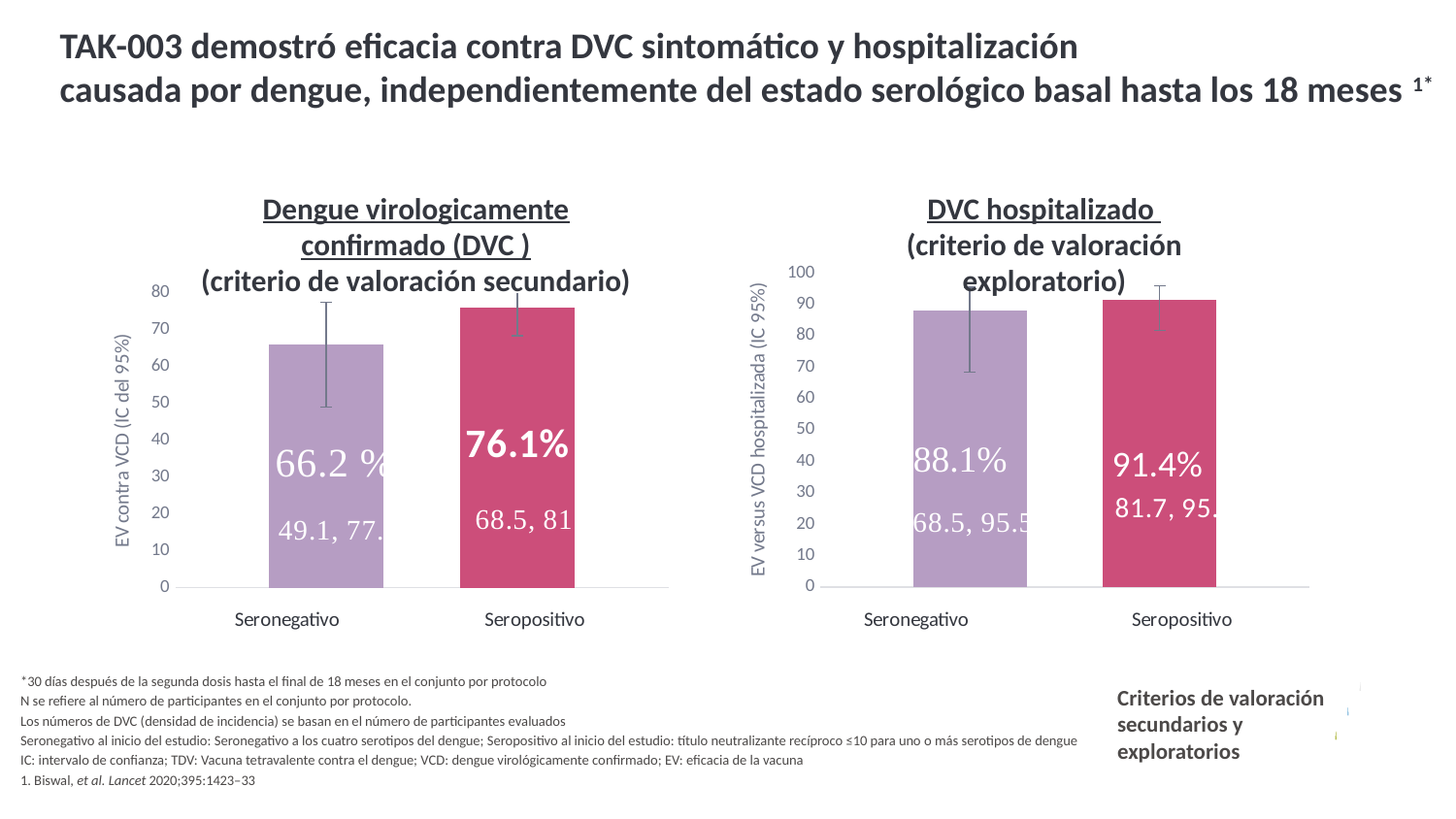
In the left chart (Dengue virologicamente confirmado), which category has the higher value? Seropositivo Is the Seronegativo value in the right chart (DVC hospitalizado) larger than the Seropositivo value in the left chart (Dengue virologicamente confirmado)? Yes In the right chart (DVC hospitalizado), which category has the lower value? Seronegativo In the right chart (DVC hospitalizado), what is the value for Seropositivo? 91.4% How many categories are shown on the x axis of the left chart (Dengue virologicamente confirmado)? 2 In the right chart (DVC hospitalizado), what is the value for Seronegativo? 88.1% In the left chart (Dengue virologicamente confirmado), what is the value for Seronegativo? 66.2 % What type of chart is the right chart (DVC hospitalizado)? Bar chart In the left chart (Dengue virologicamente confirmado), what is the difference between the Seropositivo and Seronegativo values? 9.9 percentage points What is the y-axis label of the left chart (Dengue virologicamente confirmado)? EV contra VCD (IC del 95%) In the right chart (DVC hospitalizado), what is the difference between the Seropositivo and Seronegativo values? 3.3 percentage points In the left chart (Dengue virologicamente confirmado), what is the value for Seropositivo? 76.1%